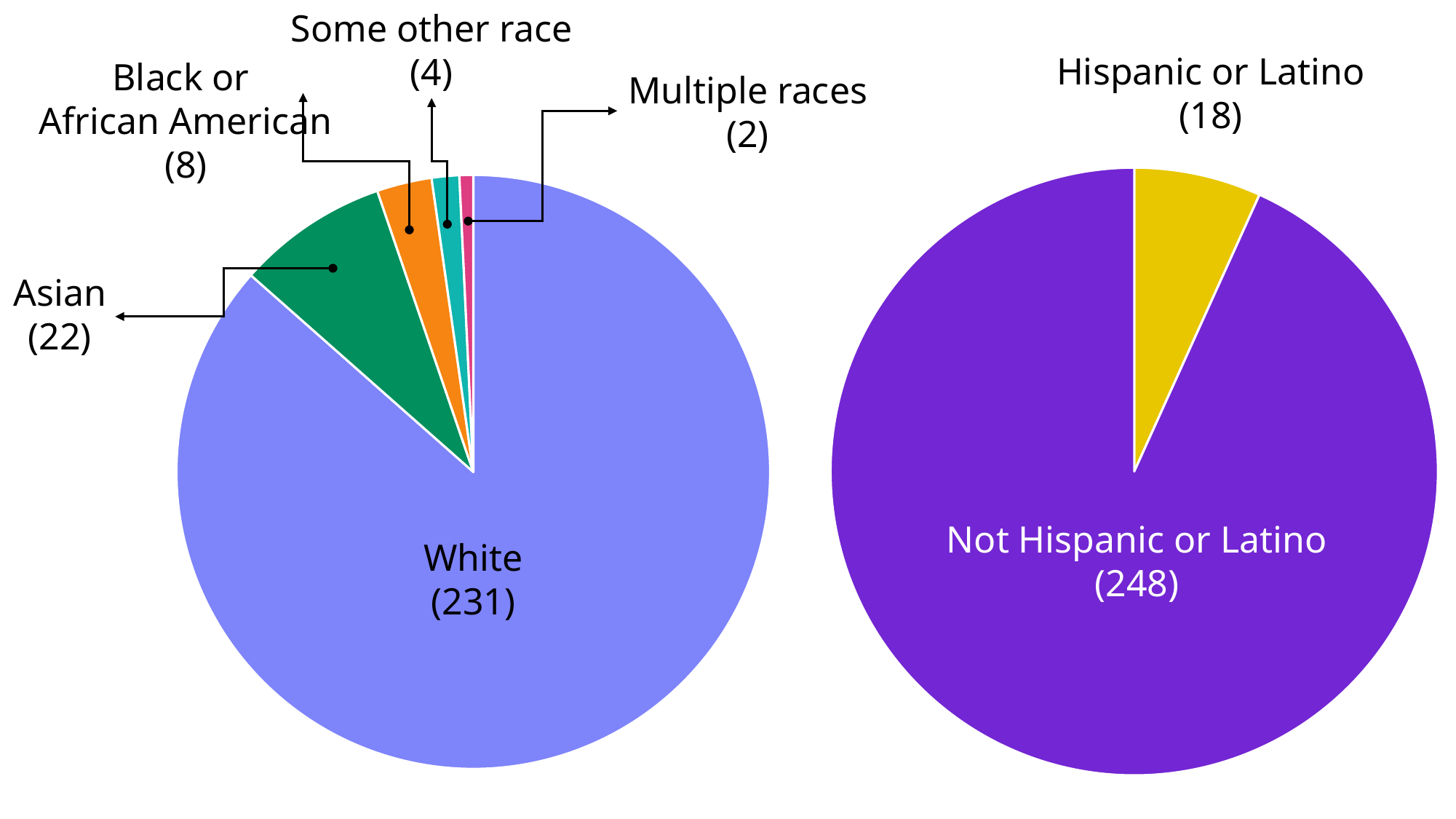
In the right pie chart, what is the value for Hispanic or Latino? 18 In the left pie chart, what is the value for White? 231 In the right pie chart, what colour is the Hispanic or Latino slice? Yellow In the left pie chart, what is the value for Black or African American? 8 In the left pie chart, which category has the largest slice? White In the left pie chart, what is the difference between the values for Asian and Black or African American? 14 In the right pie chart, what is the difference between Not Hispanic or Latino and Hispanic or Latino? 230 In the left pie chart, what is the value for Multiple races? 2 In the left pie chart, which category has the smallest slice? Multiple races In the left pie chart, what is the value for Asian? 22 What kind of chart is the left chart on the slide? Pie chart In the left pie chart, how many categories are shown? 5